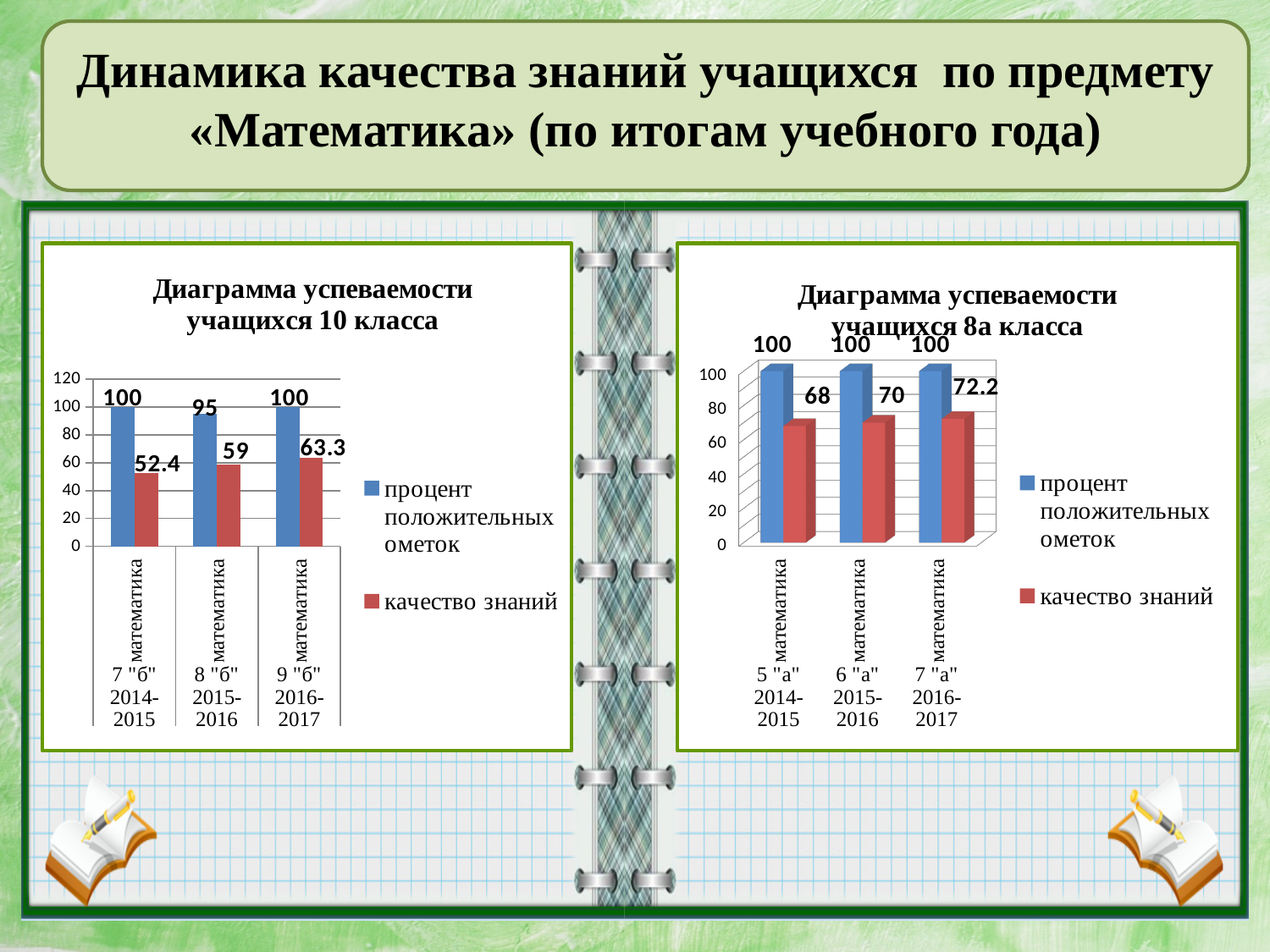
In the right chart (Диаграмма успеваемости учащихся 8а класса), which category has the lowest качество знаний? 5 "а" 2014-2015 In the left chart (Диаграмма успеваемости учащихся 10 класса), what is the difference between качество знаний for 9 "б" 2016-2017 and 7 "б" 2014-2015? 10.9 In the left chart (Диаграмма успеваемости учащихся 10 класса), what is the value of качество знаний for 7 "б" 2014-2015? 52.4 In the left chart (Диаграмма успеваемости учащихся 10 класса), how many series does the legend list? 2 In the left chart (Диаграмма успеваемости учащихся 10 класса), which category has the highest качество знаний? 9 "б" 2016-2017 In the right chart (Диаграмма успеваемости учащихся 8а класса), what is the difference between качество знаний for 6 "а" 2015-2016 and 5 "а" 2014-2015? 2 In the right chart (Диаграмма успеваемости учащихся 8а класса), how many categories are shown on the x axis? 3 In the right chart (Диаграмма успеваемости учащихся 8а класса), what is the value of качество знаний for 5 "а" 2014-2015? 68 In the left chart (Диаграмма успеваемости учащихся 10 класса), what is the value of процент положительных ометок for 8 "б" 2015-2016? 95 What type of chart is the right chart (Диаграмма успеваемости учащихся 8а класса)? bar chart In the right chart (Диаграмма успеваемости учащихся 8а класса), what is the value of качество знаний for 7 "а" 2016-2017? 72.2 In the left chart (Диаграмма успеваемости учащихся 10 класса), does качество знаний rise or fall from 2014-2015 to 2016-2017? rise